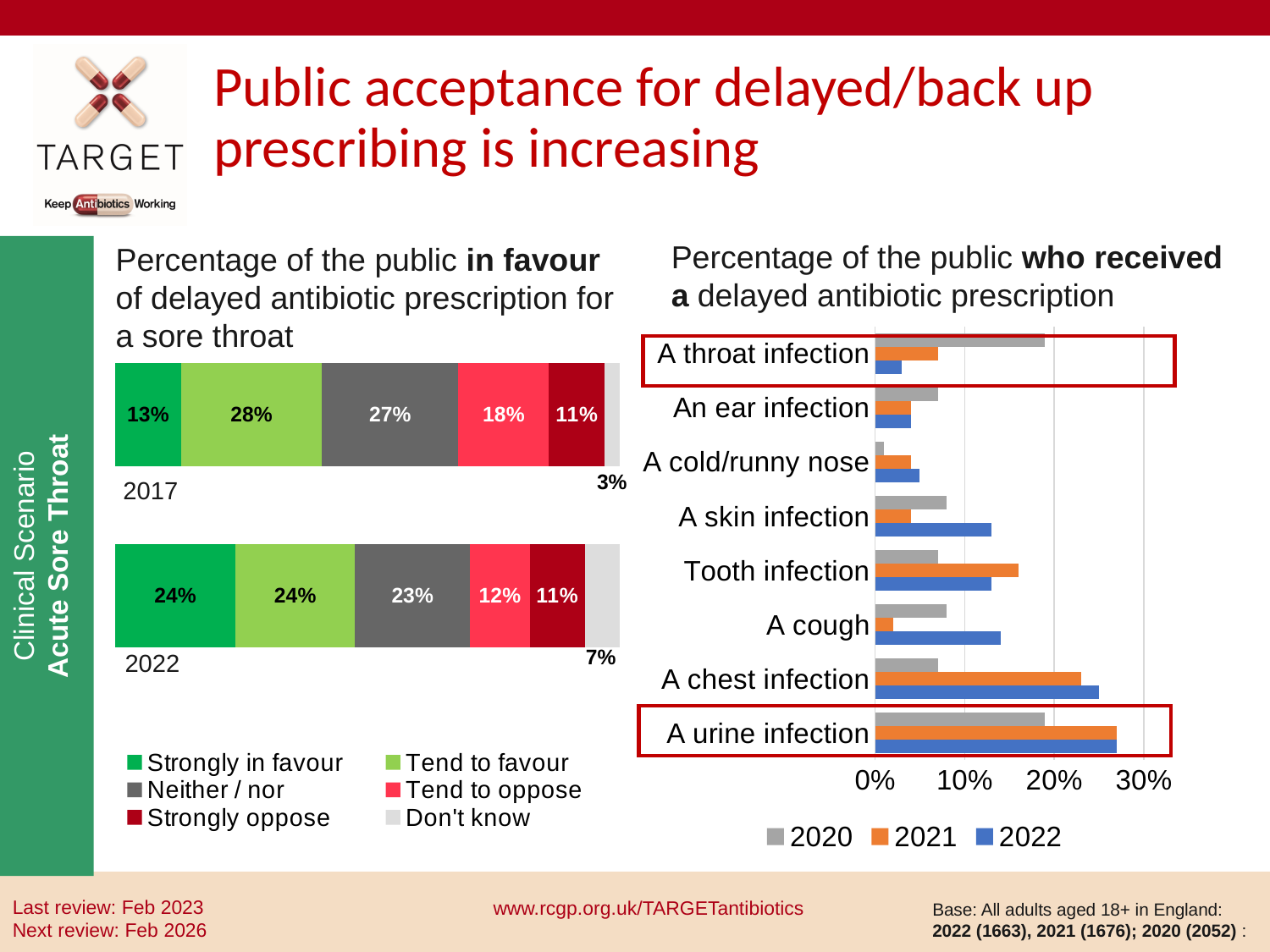
In the left chart on the percentage of the public in favour of delayed antibiotic prescription for a sore throat, by how many percentage points did 'Strongly in favour' change from 2017 to 2022? 11% In the right chart on the percentage of the public who received a delayed antibiotic prescription, is the 2022 value for 'A urine infection' greater or less than 20%? greater In the right chart on the percentage of the public who received a delayed antibiotic prescription, is the 2021 value for 'A cough' greater or less than 10%? less In the left chart on the percentage of the public in favour of delayed antibiotic prescription for a sore throat, which year had the larger 'Tend to oppose' share, 2017 or 2022? 2017 What kind of chart is the right chart on the percentage of the public who received a delayed antibiotic prescription? Bar chart In the left chart on the percentage of the public in favour of delayed antibiotic prescription for a sore throat, what percentage were 'Strongly in favour' in 2017? 13% In the right chart on the percentage of the public who received a delayed antibiotic prescription, how many years does the legend list? 3 In the right chart on the percentage of the public who received a delayed antibiotic prescription, how many infection categories are shown? 8 In the left chart on the percentage of the public in favour of delayed antibiotic prescription for a sore throat, what is the total of the 'Strongly in favour' and 'Tend to favour' segments for 2022? 48% In the left chart on the percentage of the public in favour of delayed antibiotic prescription for a sore throat, what percentage were 'Strongly in favour' in 2022? 24% In the left chart on the percentage of the public in favour of delayed antibiotic prescription for a sore throat, how many series does the legend list? 6 In the left chart on the percentage of the public in favour of delayed antibiotic prescription for a sore throat, what percentage answered 'Don't know' in 2022? 7%